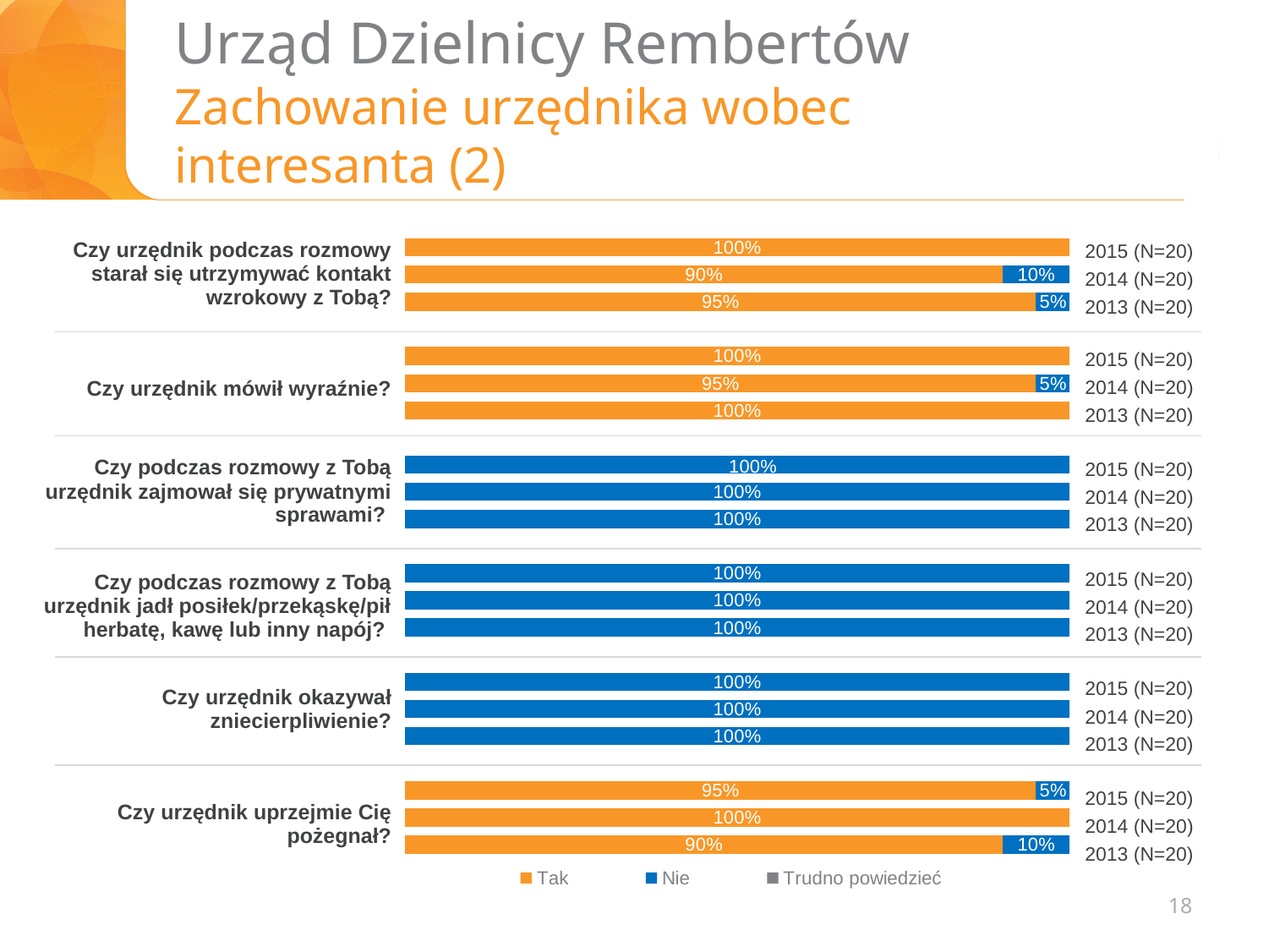
What share of respondents answered "Tak" in 2014 to "Czy urzędnik mówił wyraźnie?"? 95% For "Czy urzędnik uprzejmie Cię pożegnał?", which year had the highest "Tak" share? 2014 What share of respondents answered "Tak" in 2014 to "Czy urzędnik podczas rozmowy starał się utrzymywać kontakt wzrokowy z Tobą?"? 90% What share of respondents answered "Nie" in 2013 to "Czy urzędnik uprzejmie Cię pożegnał?"? 10% What is the difference between the "Tak" share in 2015 and in 2014 for "Czy urzędnik podczas rozmowy starał się utrzymywać kontakt wzrokowy z Tobą?"? 10 percentage points Is the "Tak" share for "Czy urzędnik mówił wyraźnie?" larger in 2015 or in 2014? 2015 What share of respondents answered "Nie" in 2013 to "Czy urzędnik podczas rozmowy starał się utrzymywać kontakt wzrokowy z Tobą?"? 5% How many series does the legend list? 3 What share of respondents answered "Nie" in 2015 to "Czy urzędnik okazywał zniecierpliwienie?"? 100% For "Czy urzędnik podczas rozmowy starał się utrzymywać kontakt wzrokowy z Tobą?", which year had the lowest "Tak" share? 2014 What type of chart is shown on the slide? Stacked bar chart What share of respondents answered "Tak" in 2015 to "Czy urzędnik uprzejmie Cię pożegnał?"? 95%